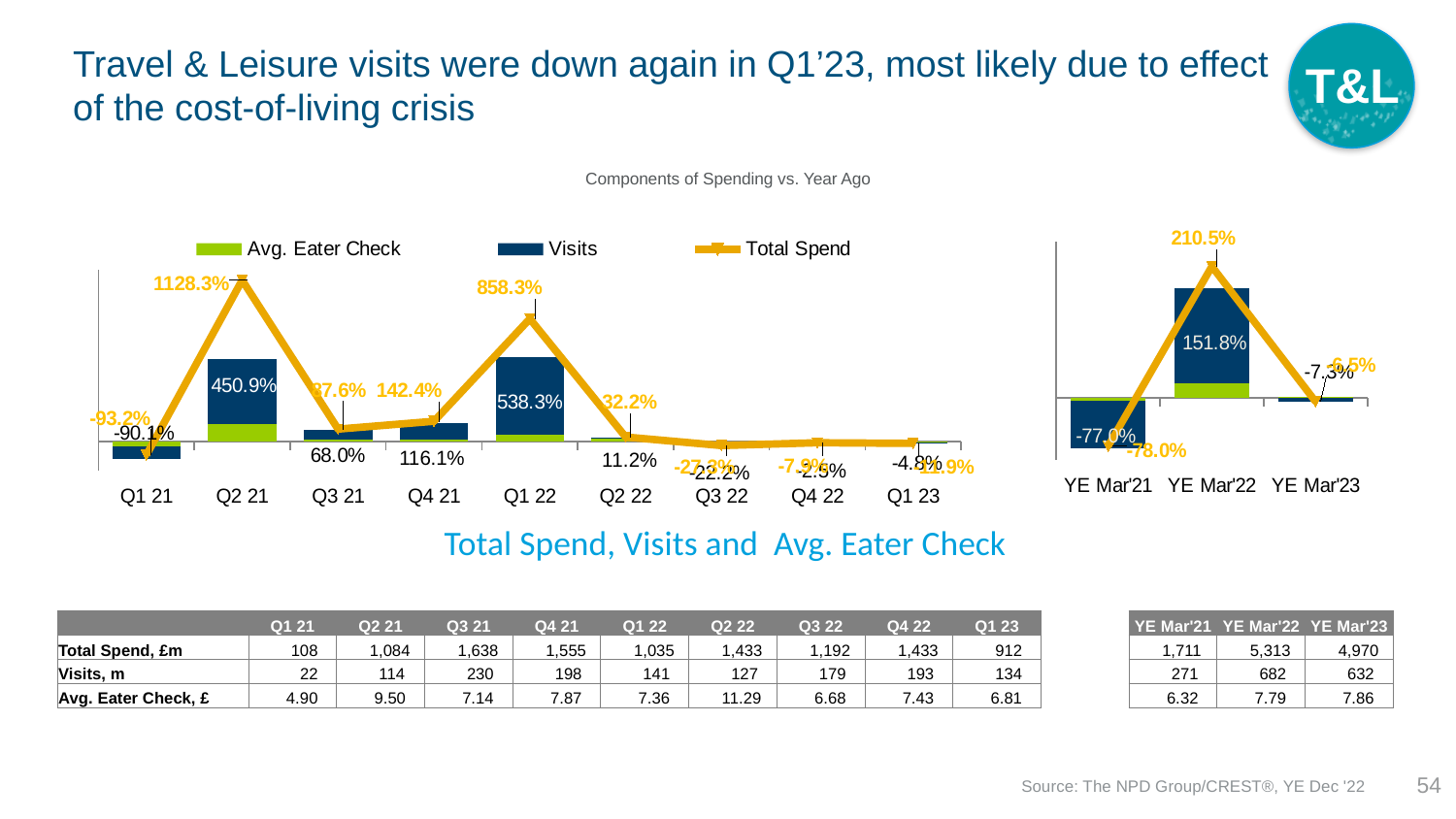
How many quarters are shown on the x axis of the left chart? 9 In the left chart, which is larger: the Visits value for Q2 21 or for Q1 22? Q1 22 In the right chart, what is the Visits value for YE Mar'21? -77.0% In the left chart, what is the difference between the Total Spend values for Q2 21 and Q1 22? 270.0 percentage points In the left chart, which quarter has the lowest Visits value? Q1 21 In the left chart, what is the Visits value for Q1 22? 538.3% In the right chart, how does the Total Spend line move from YE Mar'21 to YE Mar'23? Rises then falls In the left chart, which quarter has the highest Total Spend value? Q2 21 What type of chart is the left chart showing quarterly Components of Spending vs. Year Ago? Combined bar and line chart In the left chart, what is the Total Spend value for Q2 21? 1128.3% In the right chart, what is the Total Spend value for YE Mar'22? 210.5% How many series does the legend of the left chart list? 3